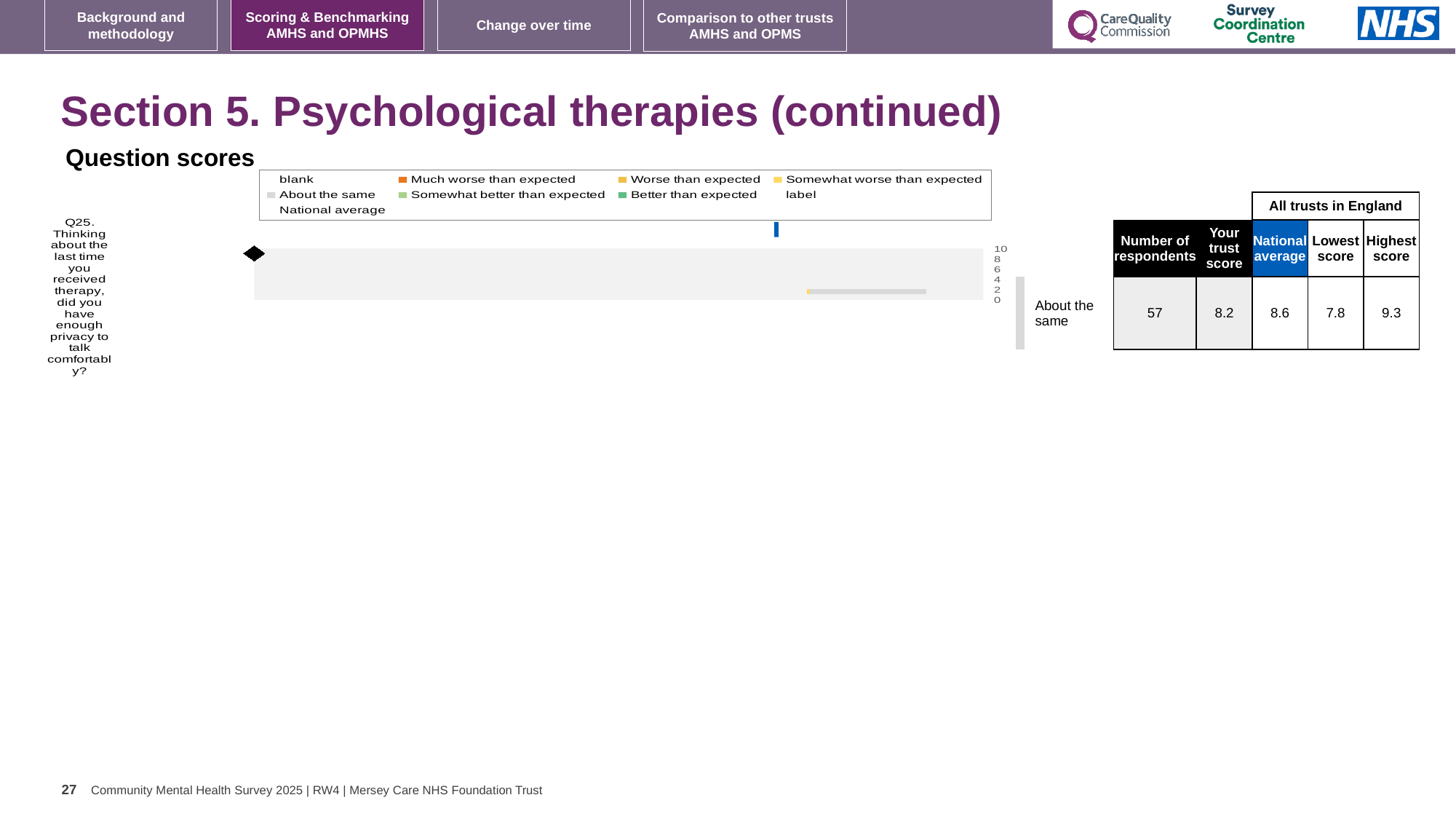
Which question is plotted on the chart? Q25 What benchmark category is shown next to the chart for Q25? About the same What is the highest value shown on the chart's score axis? 10 How many survey questions are plotted on the chart? 1 What kind of chart is shown under 'Question scores'? bar chart What is the lowest value shown on the chart's score axis? 0